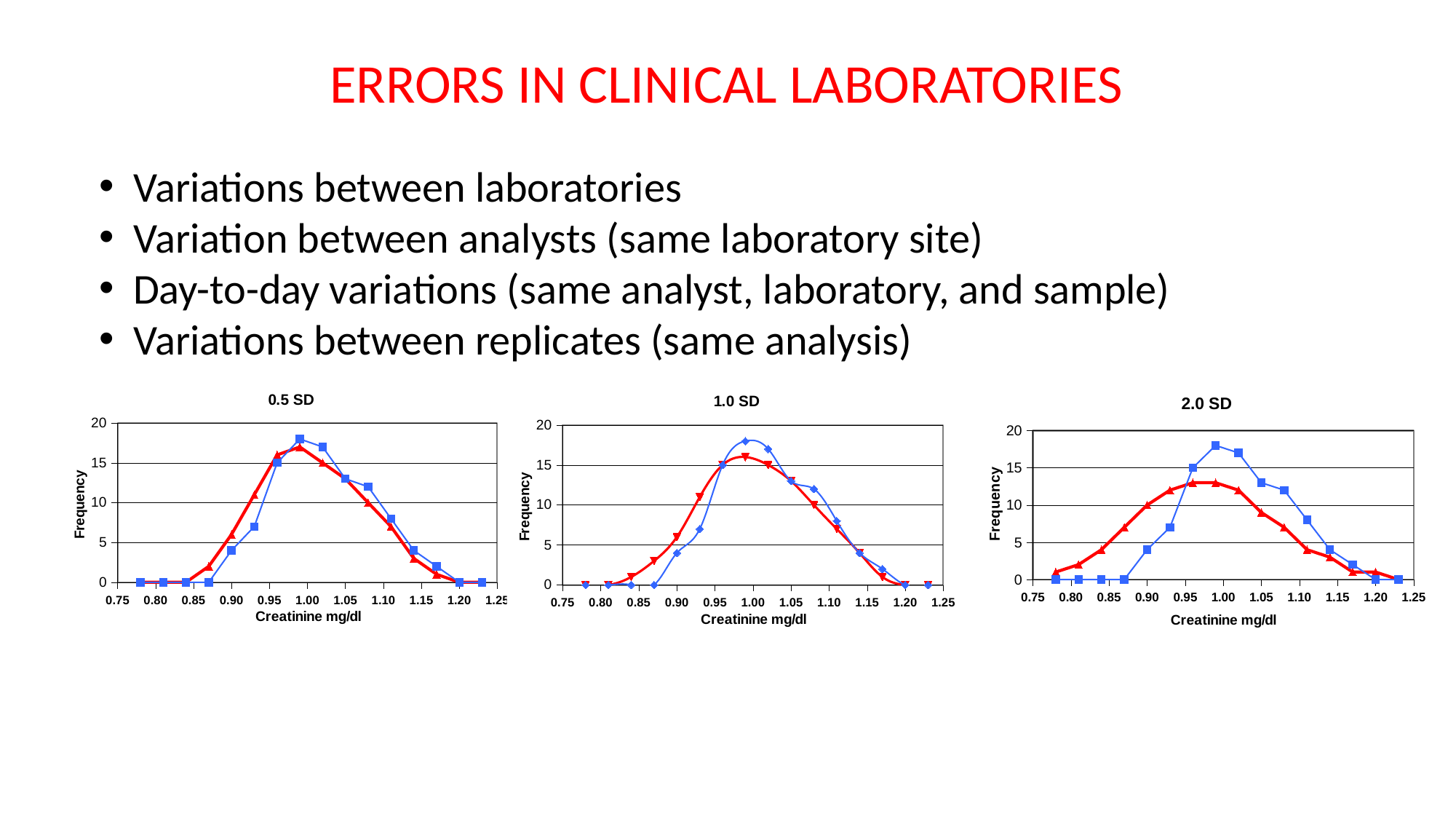
What kind of chart is the chart titled "0.5 SD"? line chart What is the title of the rightmost chart on the slide? 2.0 SD In the chart titled "0.5 SD", is the peak value of the blue line greater or less than 15? greater In the chart titled "1.0 SD", is the peak value of the blue line greater or less than 15? greater In the chart titled "2.0 SD", is the peak value of the red line greater or less than 15? less How many charts are shown on the slide? 3 How many lines are plotted in the chart titled "1.0 SD"? 2 What is the x-axis label of the chart titled "1.0 SD"? Creatinine mg/dl